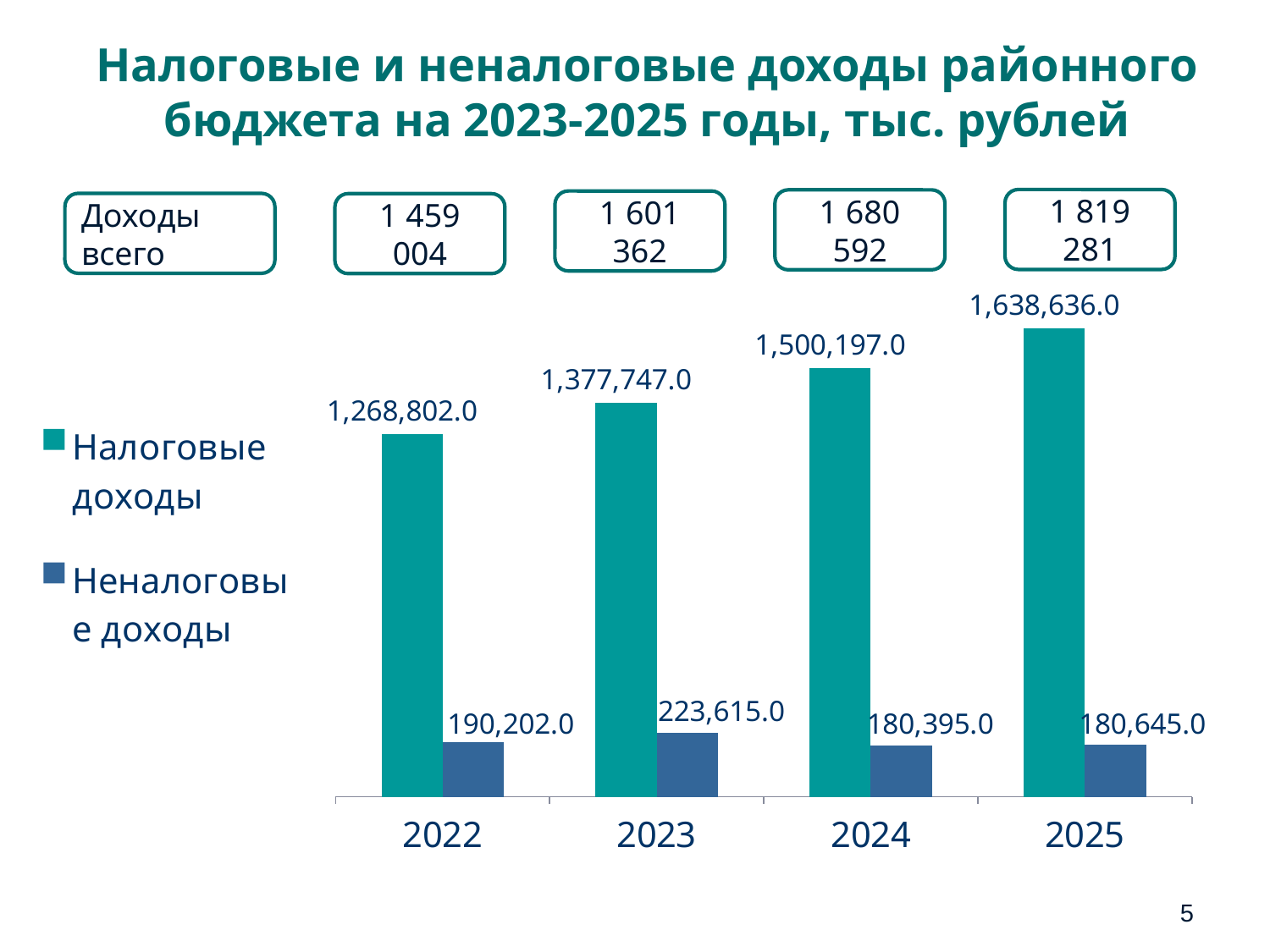
In which year are Неналоговые доходы the highest? 2023 What is the difference between Неналоговые доходы in 2023 and in 2022? 33,413.0 In which year are Налоговые доходы the lowest? 2022 What is the value of Налоговые доходы for 2025? 1,638,636.0 Which is larger: Налоговые доходы in 2024 or in 2023? 2024 How many series does the legend list? 2 In which year are Налоговые доходы the highest? 2025 What is the value of Неналоговые доходы for 2023? 223,615.0 What is the value of Неналоговые доходы for 2024? 180,395.0 How many years are shown on the x axis of the chart? 4 What is the difference between Налоговые доходы in 2025 and in 2022? 369,834.0 What is the value of Налоговые доходы for 2022? 1,268,802.0